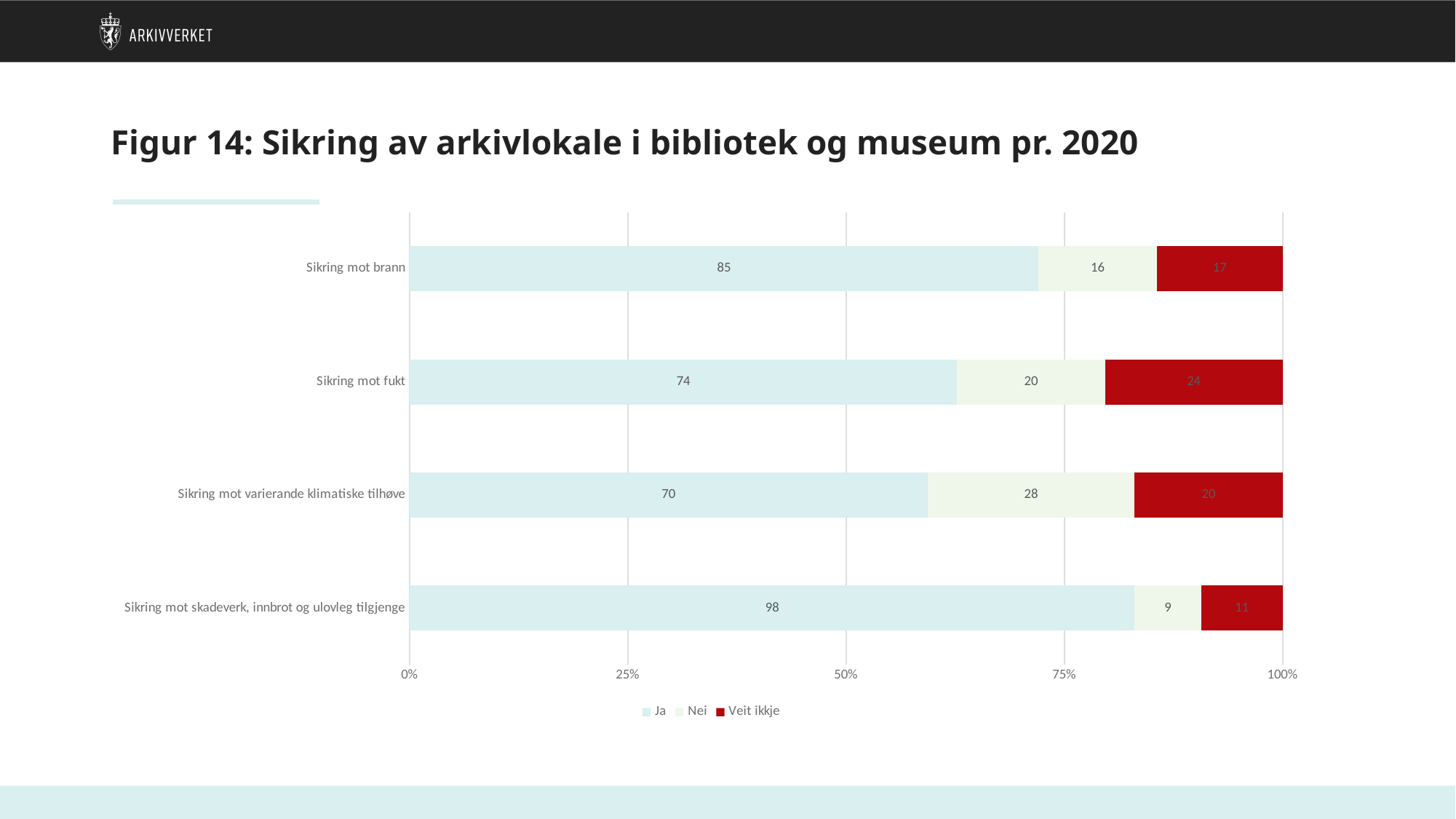
What is the 'Nei' value for 'Sikring mot varierande klimatiske tilhøve'? 28 What is the 'Ja' value for 'Sikring mot brann'? 85 What is the 'Veit ikkje' value for 'Sikring mot fukt'? 24 Which series is shown in red? Veit ikkje Which category has the highest 'Ja' value? Sikring mot skadeverk, innbrot og ulovleg tilgjenge What is the difference between the 'Ja' values for 'Sikring mot brann' and 'Sikring mot fukt'? 11 Which is larger: the 'Veit ikkje' value for 'Sikring mot brann' or for 'Sikring mot varierande klimatiske tilhøve'? Sikring mot varierande klimatiske tilhøve Which category has the lowest 'Nei' value? Sikring mot skadeverk, innbrot og ulovleg tilgjenge How many series does the legend list? 3 What is the total of the three values in the 'Sikring mot skadeverk, innbrot og ulovleg tilgjenge' bar? 118 How many categories are shown on the chart? 4 What kind of chart is shown on the slide? Stacked bar chart